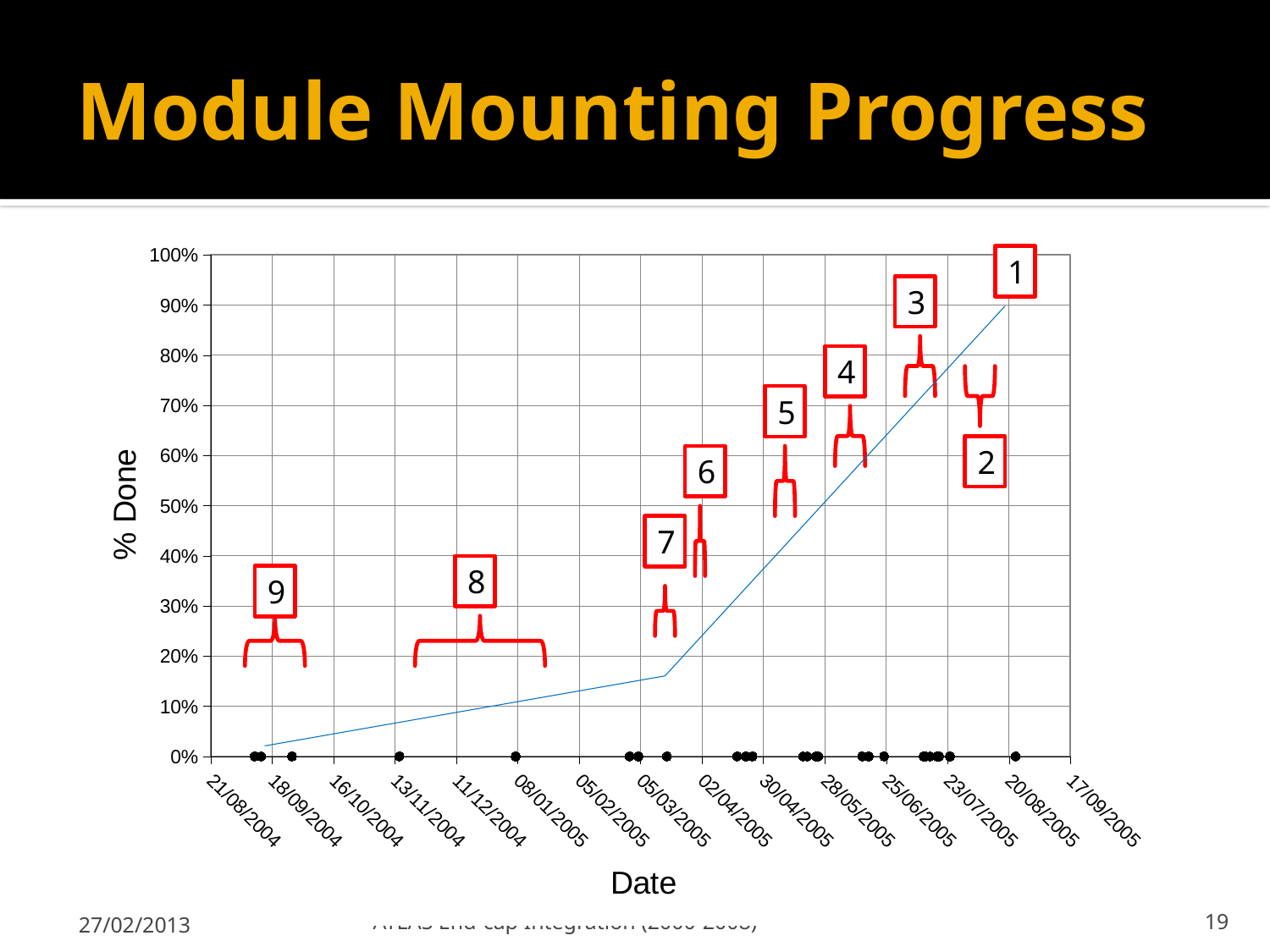
How many numbered red annotation boxes are placed on the chart? 9 Is the % Done value at 30/04/2005 greater or less than 30%? greater Is the % Done value at 05/03/2005 greater or less than 20%? less How many date labels are shown on the x axis? 15 What kind of chart is shown on the slide? line chart What is the label of the y axis? % Done Is the % Done value at 23/07/2005 greater or less than 70%? greater Does the % Done value rise or fall along the x axis from 21/08/2004 to 20/08/2005? rise Which date on the x axis has the higher % Done value, 05/03/2005 or 20/08/2005? 20/08/2005